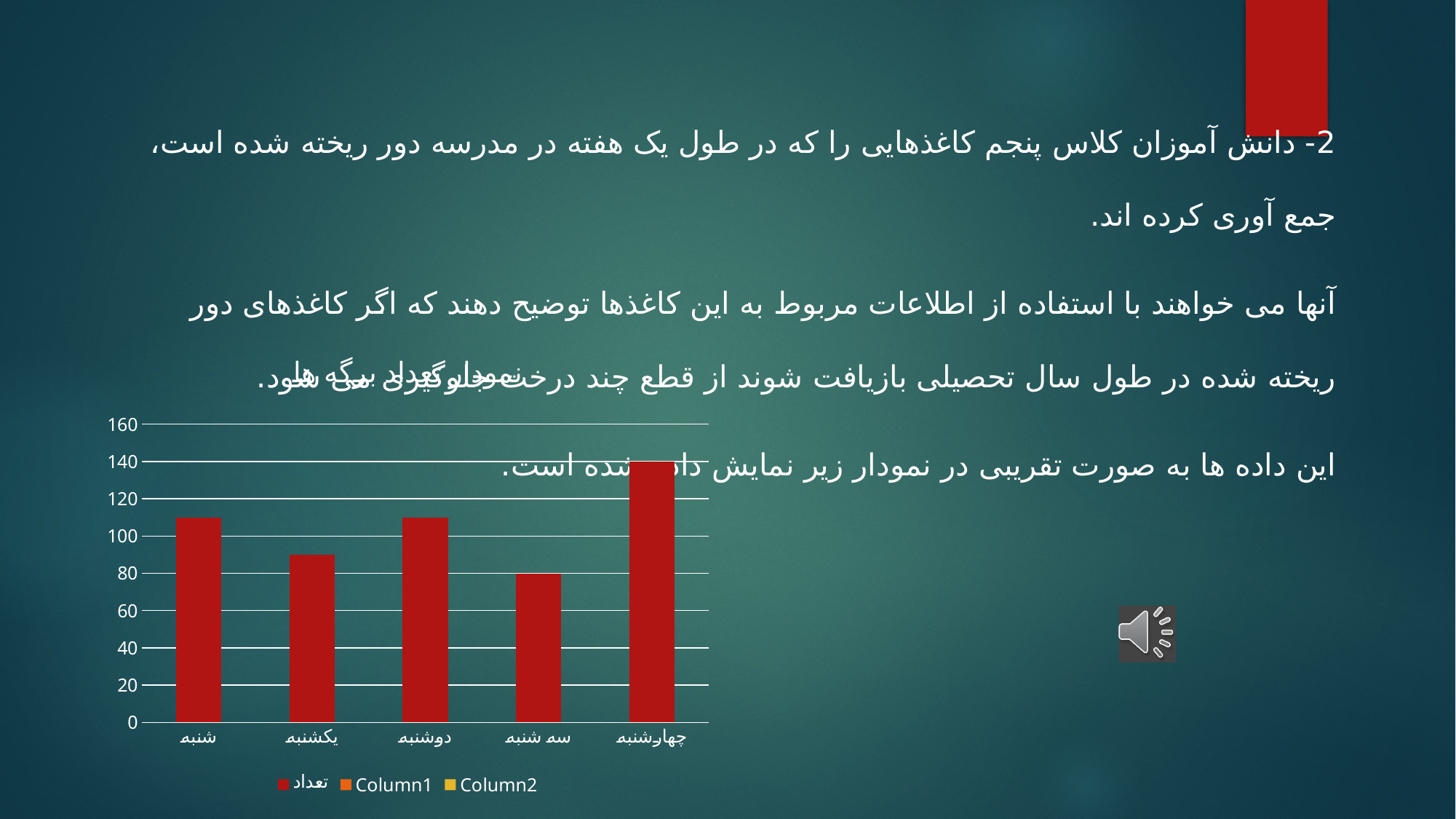
How many categories (days) are shown on the x axis of the chart? 5 What is the value for سه شنبه in the chart? 80 What is the difference between the values for چهارشنبه and سه شنبه? 60 What kind of chart is shown on the slide? bar chart Which day has the highest bar in the chart? چهارشنبه Which day has the lowest bar in the chart? سه شنبه Is the value for یکشنبه greater or less than 100? less How many series does the chart's legend list? 3 Is the value for شنبه greater or less than 100? greater What is the value for چهارشنبه in the chart? 140 Which is larger, the value for شنبه or the value for یکشنبه? شنبه What is the name of the first (red) series in the chart's legend? تعداد